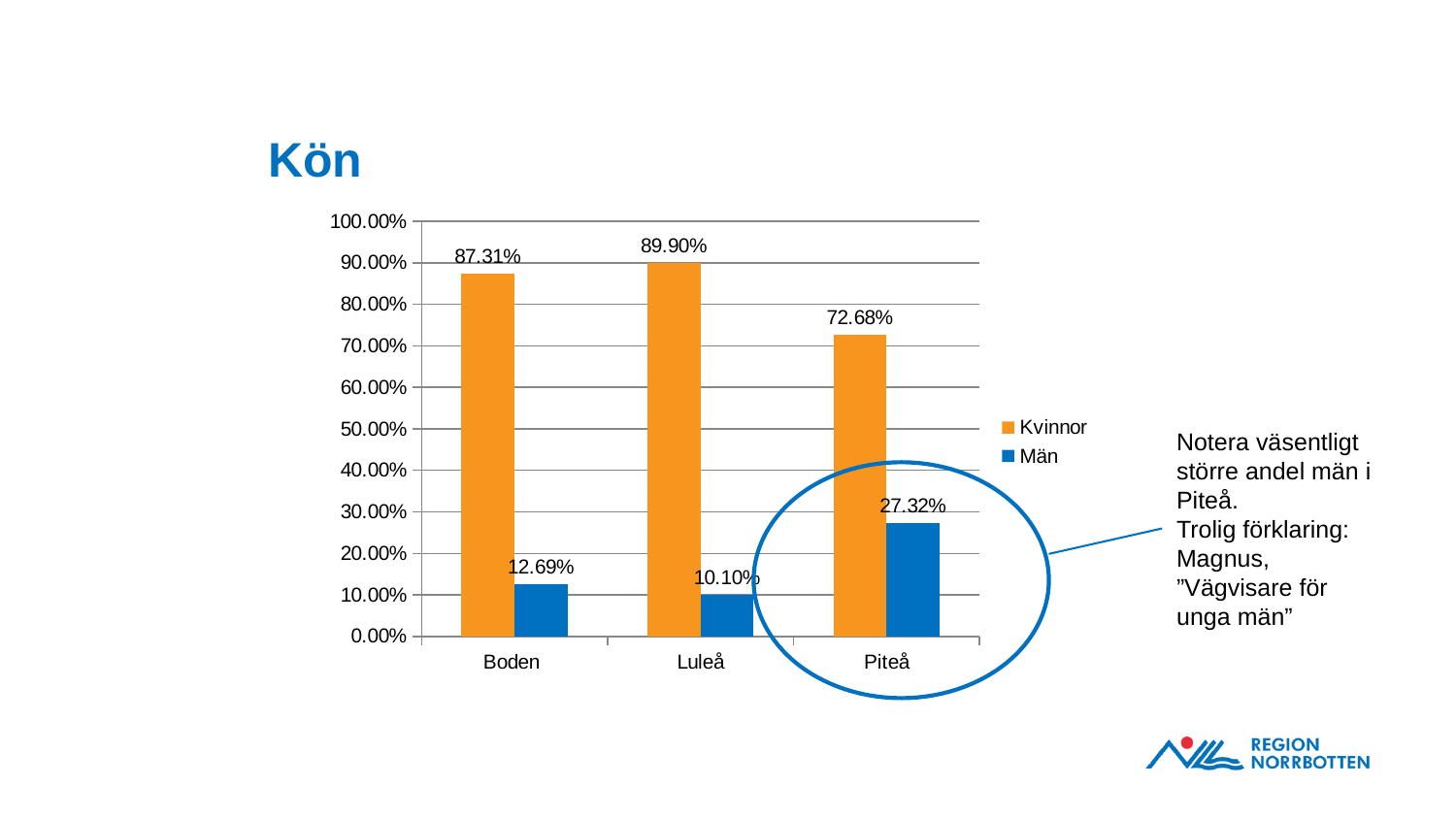
What is the difference between the Kvinnor values for Luleå and Piteå? 17.22% Which is larger, the Män value for Boden or the Män value for Piteå? Piteå What is the value for Män in Piteå? 27.32% Which category has the highest value for Kvinnor? Luleå Which category has the lowest value for Män? Luleå How many series does the legend list? 2 What is the value for Kvinnor in Luleå? 89.90% What is the value for Män in Luleå? 10.10% How many categories are shown on the x axis? 3 What kind of chart is shown on the slide? Bar chart What is the value for Kvinnor in Boden? 87.31% What is the title of the slide? Kön